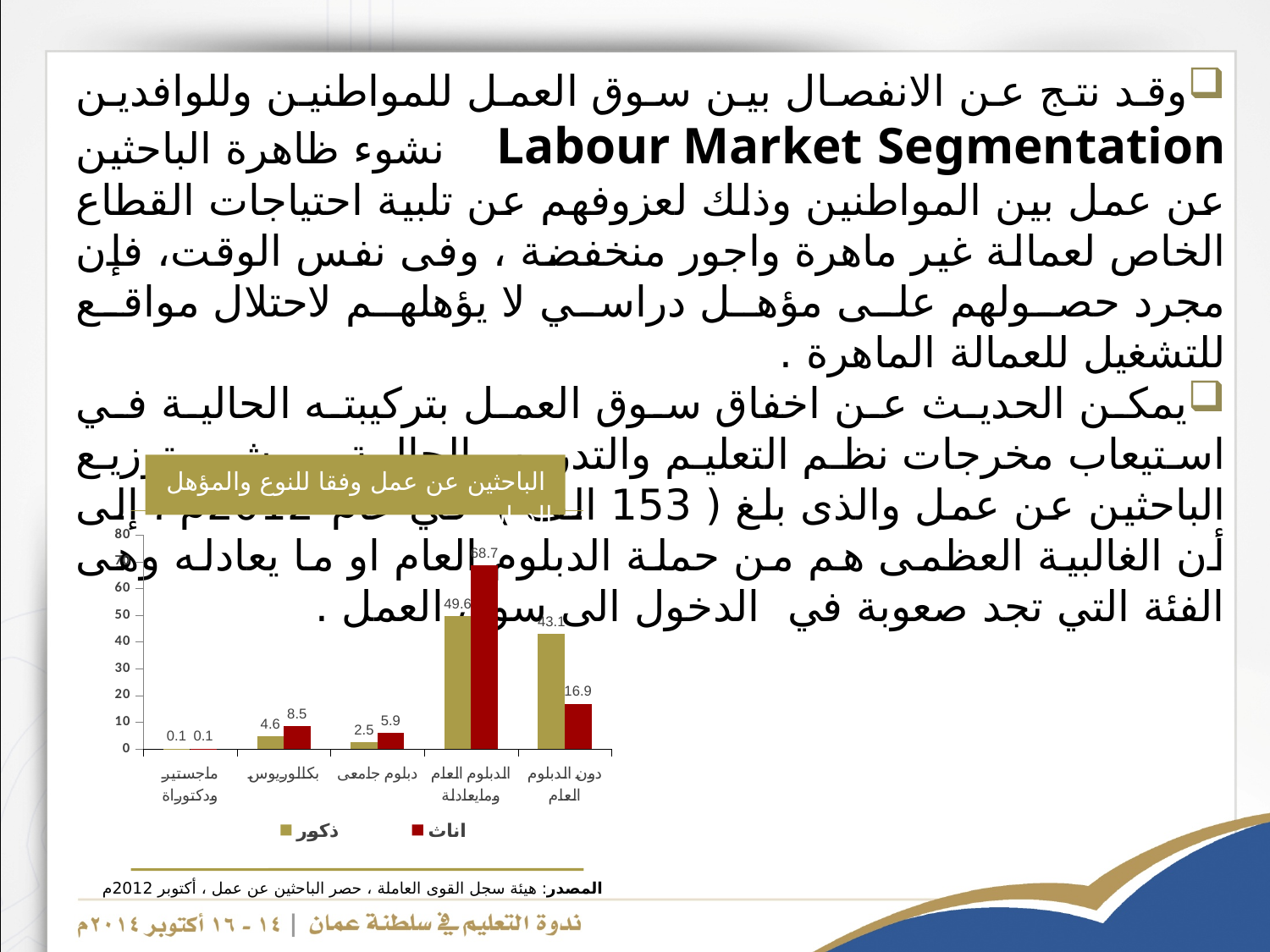
What type of chart is shown on the slide? bar chart How many qualification categories are shown on the x axis of the chart? 5 What is the value for ذكور (males) in the دون الدبلوم العام category? 43.1 Which series is shown in red in the chart? اناث In the دون الدبلوم العام category, which series has the larger value, ذكور or اناث? ذكور What is the value for اناث (females) in the الدبلوم العام وما يعادله category? 68.7 How many series does the chart legend list? 2 Which category has the lowest value for ذكور (males)? ماجستير ودكتوراة What is the difference between the اناث and ذكور values in the الدبلوم العام وما يعادله category? 19.1 Which category has the highest value for اناث (females)? الدبلوم العام وما يعادله What is the value for اناث (females) in the بكالوريوس category? 8.5 What is the value for ذكور (males) in the الدبلوم العام وما يعادله category? 49.6